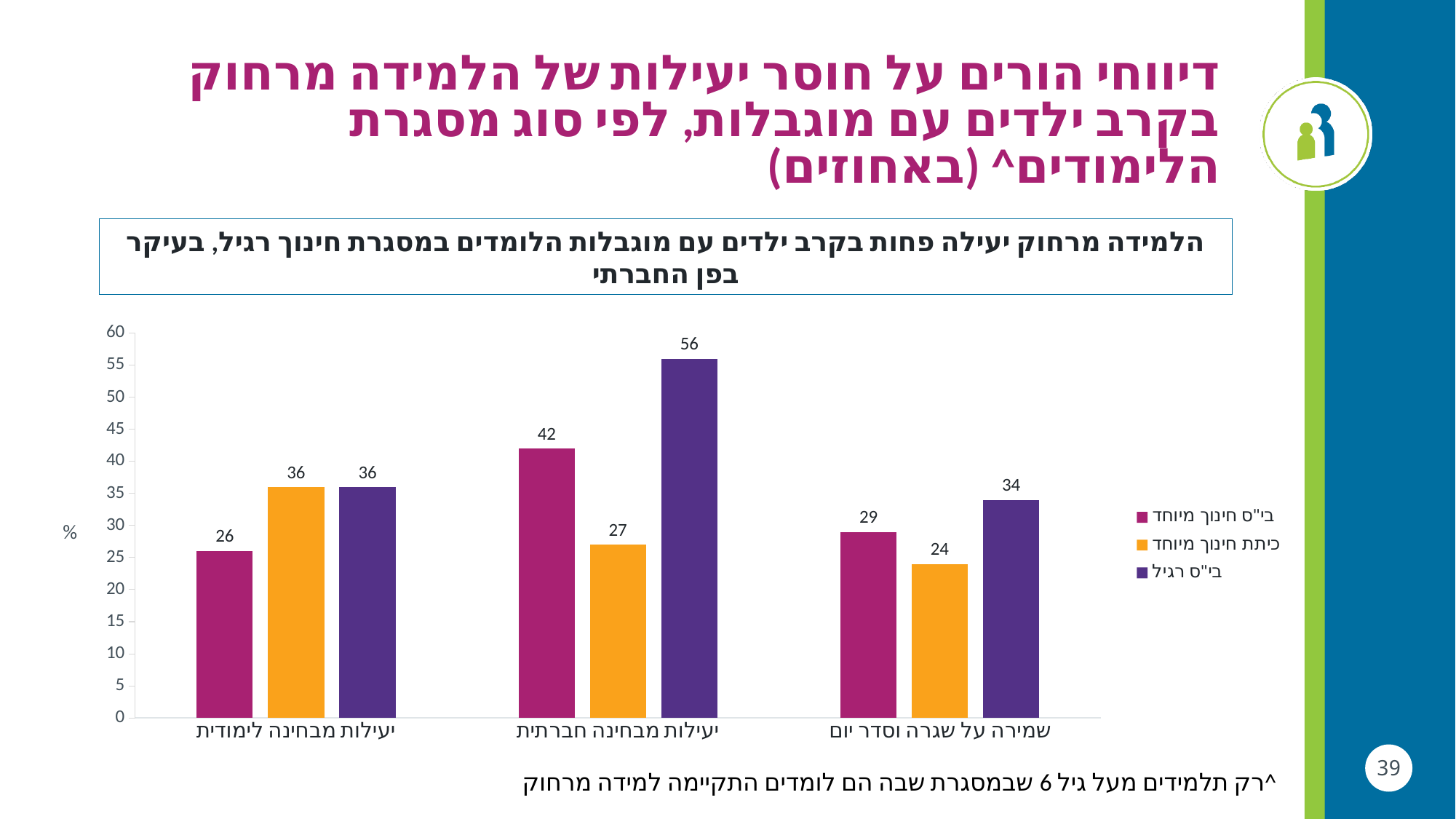
Which is larger: the בי"ס חינוך מיוחד value for יעילות מבחינה חברתית or for שמירה על שגרה וסדר יום? יעילות מבחינה חברתית What colour are the bars for the series בי"ס רגיל? purple Which series has the lowest value in the category שמירה על שגרה וסדר יום? כיתת חינוך מיוחד Is the value for בי"ס רגיל in the category יעילות מבחינה חברתית greater or less than 50? greater Which series has the highest value in the category יעילות מבחינה חברתית? בי"ס רגיל How many series does the legend list? 3 How many categories are shown on the x axis? 3 What type of chart is shown on the slide? bar chart What is the value for בי"ס חינוך מיוחד in the category יעילות מבחינה לימודית? 26 What is the value for בי"ס רגיל in the category יעילות מבחינה חברתית? 56 What is the value for כיתת חינוך מיוחד in the category שמירה על שגרה וסדר יום? 24 What is the difference between the בי"ס רגיל and כיתת חינוך מיוחד values in the category יעילות מבחינה חברתית? 29